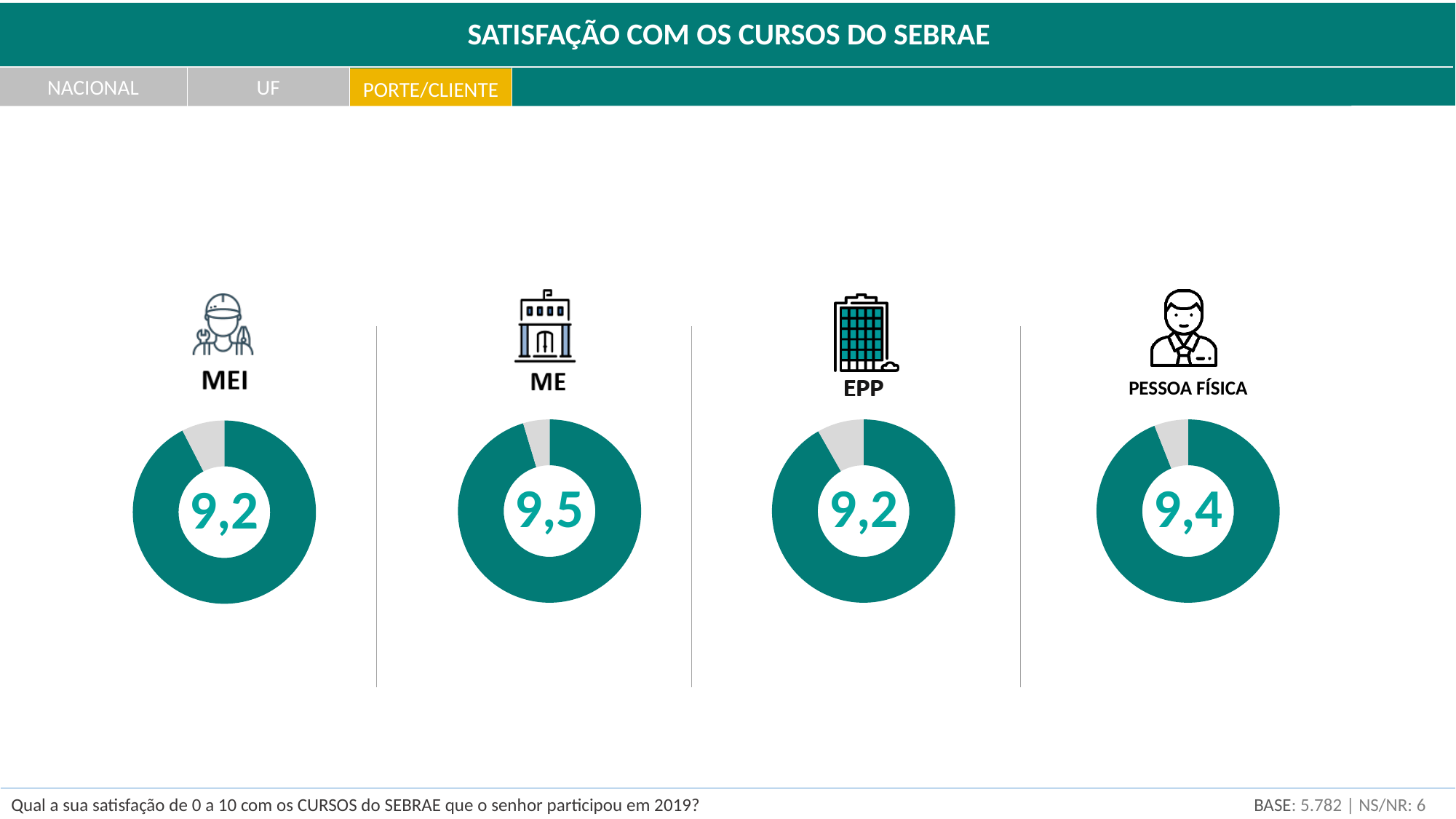
What is the satisfaction score shown in the PESSOA FÍSICA donut chart? 9,4 How many donut charts are shown on the slide? 4 What is the satisfaction score shown in the EPP donut chart? 9,2 Which is larger, the ME score or the PESSOA FÍSICA score? ME What is the satisfaction score shown in the ME donut chart? 9,5 What is the satisfaction score shown in the MEI donut chart? 9,2 What kind of chart is used to display each category's score? Donut chart Which two categories share the lowest satisfaction score across the four donut charts? MEI and EPP Which category has the highest satisfaction score across the four donut charts? ME What is the title of the slide containing the donut charts? SATISFAÇÃO COM OS CURSOS DO SEBRAE What is the difference between the PESSOA FÍSICA score and the EPP score? 0,2 What is the difference between the ME score and the MEI score? 0,3